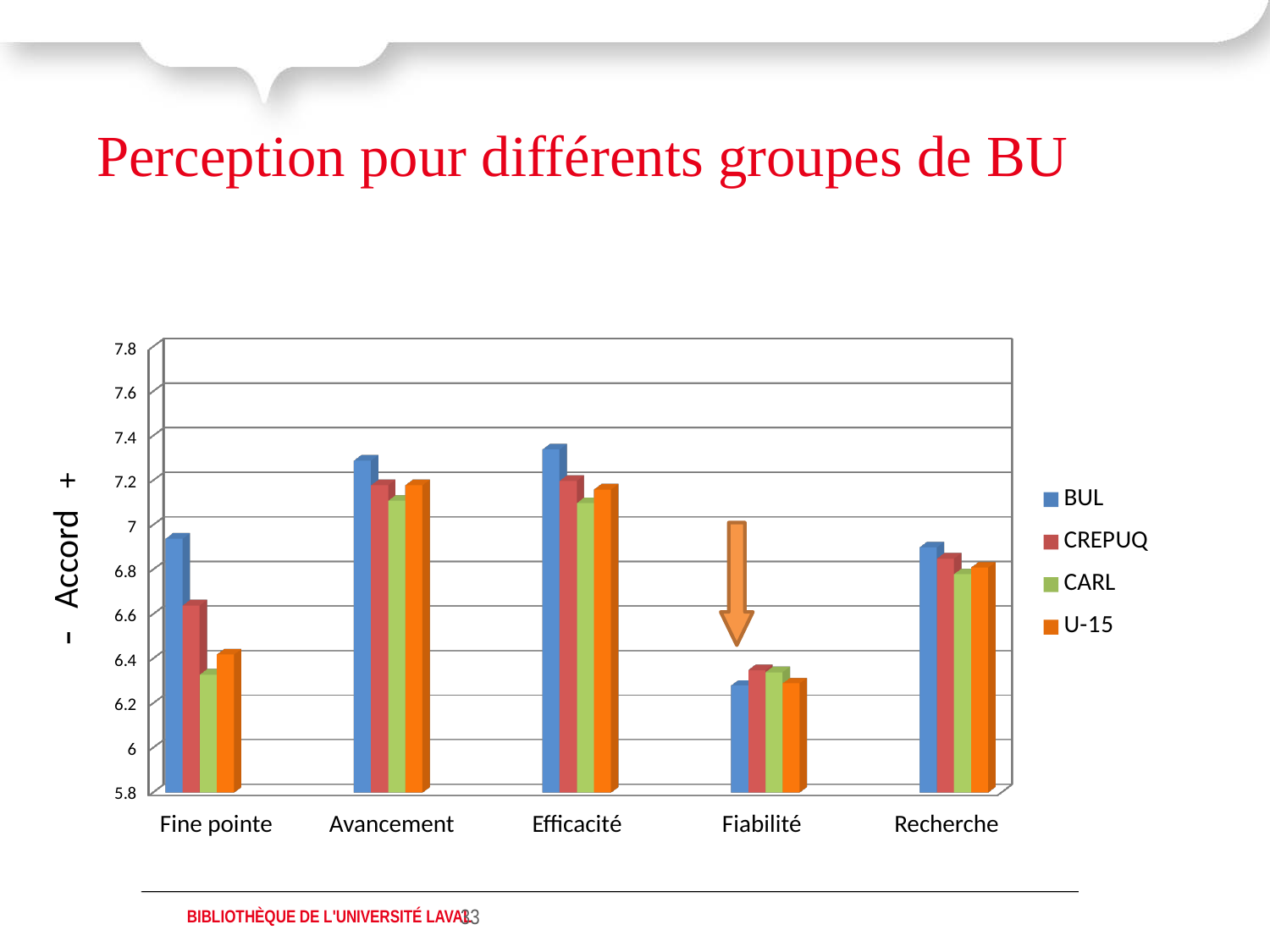
Is the CARL value for Fine pointe greater or less than 6.4? less Is the BUL value for Fine pointe greater or less than 6.8? greater What is the title of the slide containing the chart? Perception pour différents groupes de BU How many categories are shown on the x axis of the chart? 5 What kind of chart is shown on the slide? bar chart Is the BUL value for Efficacité greater or less than 7.2? greater Which category has the lowest BUL value? Fiabilité How many series does the chart's legend list? 4 For Fine pointe, which is larger: the BUL value or the CARL value? BUL Which series are listed in the chart's legend? BUL, CREPUQ, CARL, U-15